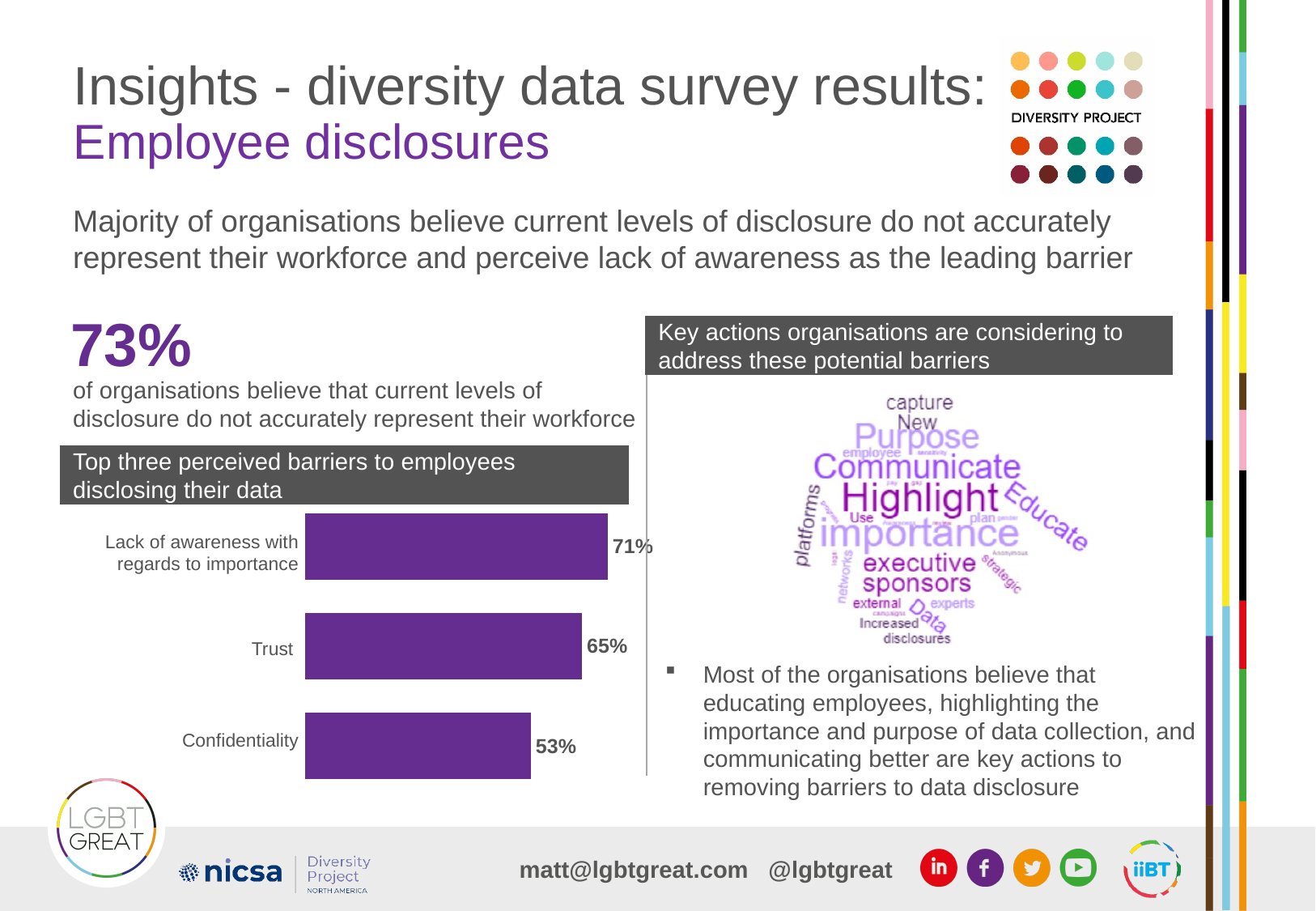
Which is larger, the value for Trust or the value for Confidentiality? Trust What is the title of the bar chart on the slide? Top three perceived barriers to employees disclosing their data Which perceived barrier has the lowest value in the bar chart? Confidentiality What is the difference between the values for Trust and Confidentiality? 12% What kind of chart is used to show the top three perceived barriers? Bar chart What is the value shown for Trust in the bar chart of perceived barriers? 65% What is the value shown for Confidentiality in the bar chart? 53% What percentage of organisations cited lack of awareness with regards to importance as a barrier to employees disclosing their data? 71% What is the difference between the values for Lack of awareness with regards to importance and Trust? 6% Which perceived barrier has the highest value in the bar chart? Lack of awareness with regards to importance What colour are the bars in the chart of perceived barriers? Purple How many barriers are plotted in the bar chart? 3